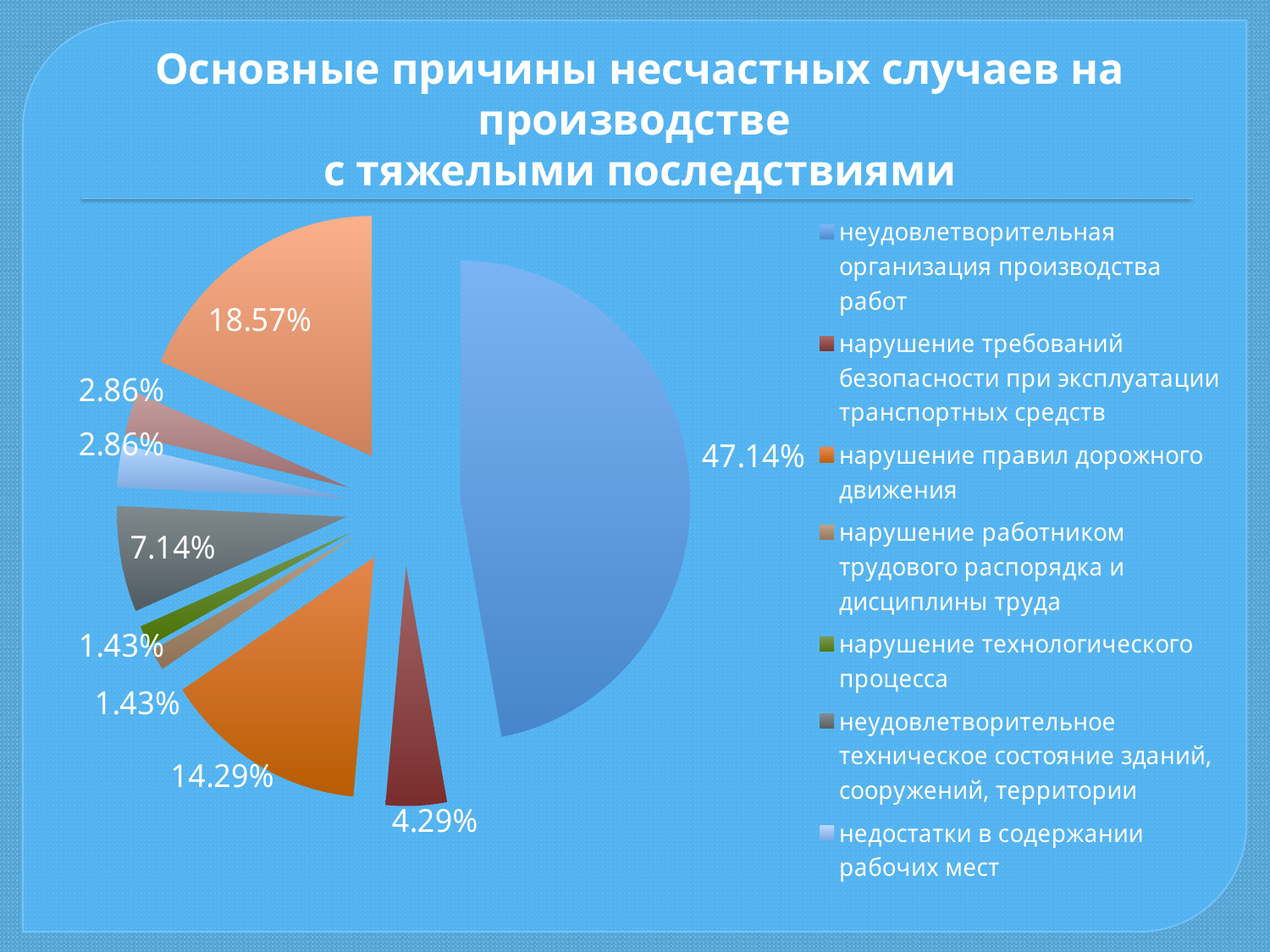
What percentage is shown for "неудовлетворительное техническое состояние зданий, сооружений, территории"? 7.14% What percentage is shown for "недостатки в содержании рабочих мест"? 2.86% How many slices does the pie chart have? 9 What percentage is shown for "нарушение правил дорожного движения"? 14.29% What percentage is shown for "нарушение требований безопасности при эксплуатации транспортных средств"? 4.29% Which legend category has the largest slice of the pie? неудовлетворительная организация производства работ By how many percentage points does the slice for "неудовлетворительная организация производства работ" exceed the slice for "нарушение правил дорожного движения"? 32.85 What share of the pie is labelled for "неудовлетворительная организация производства работ"? 47.14% How many entries does the legend list? 7 What percentage is shown for "нарушение технологического процесса"? 1.43% Which is larger: the slice for "неудовлетворительное техническое состояние зданий, сооружений, территории" or the slice for "нарушение требований безопасности при эксплуатации транспортных средств"? неудовлетворительное техническое состояние зданий, сооружений, территории What kind of chart is shown on the slide? pie chart